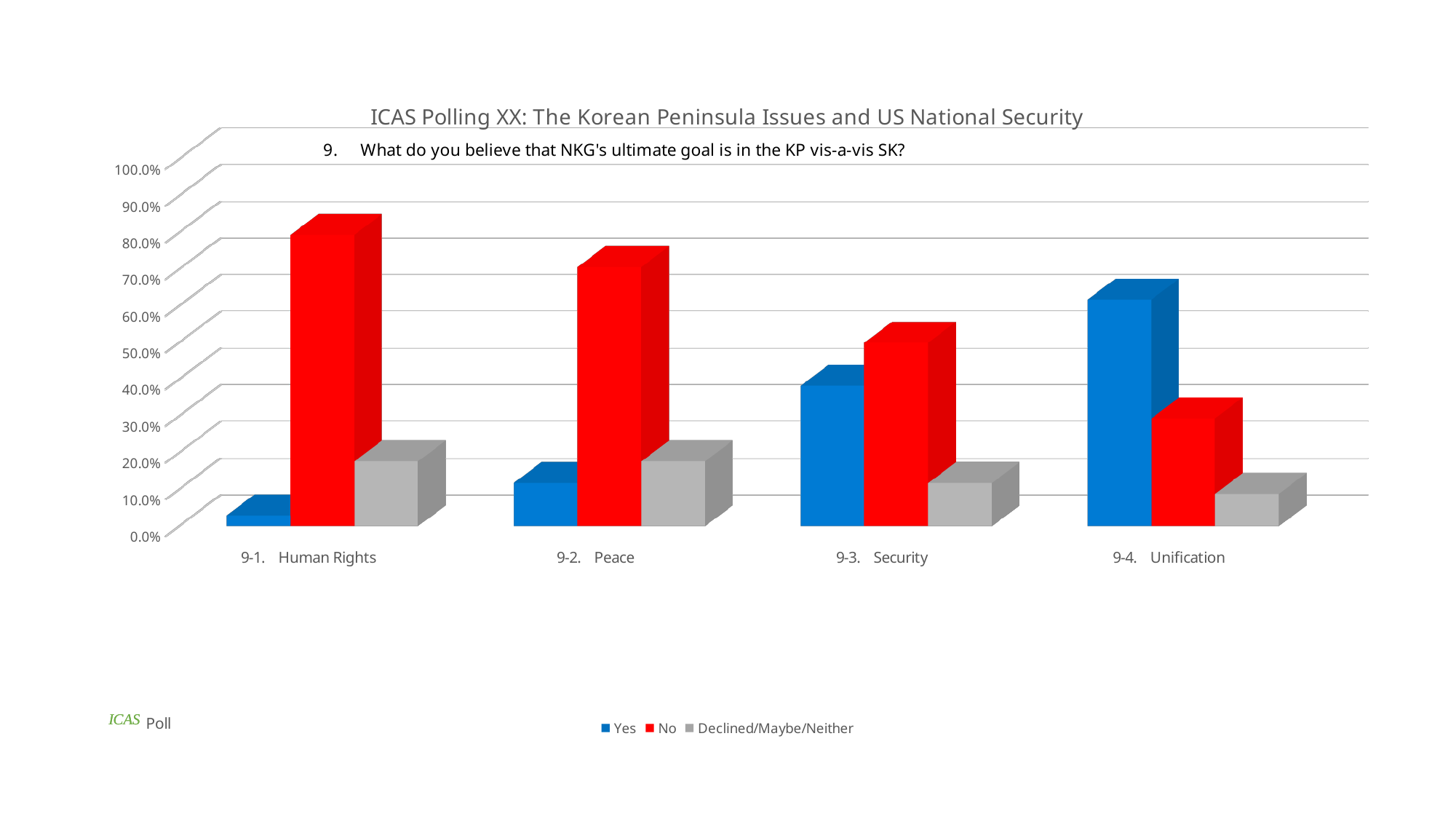
Which category has the shortest "Yes" bar? 9-1. Human Rights Which category has the tallest "No" bar? 9-1. Human Rights For 9-4. Unification, which is larger, the "Yes" bar or the "No" bar? Yes Is the "No" value for 9-1. Human Rights greater or less than 70.0%? greater Which series is shown in red in the chart's legend? No How many series does the chart's legend list? 3 How many categories are shown on the x axis of the chart? 4 What kind of chart is shown on the slide? Bar chart Is the "Yes" value for 9-3. Security greater or less than 50.0%? less Which category has the tallest "Yes" bar? 9-4. Unification For 9-3. Security, which is larger, the "Yes" bar or the "No" bar? No Is the "Yes" value for 9-4. Unification greater or less than 50.0%? greater